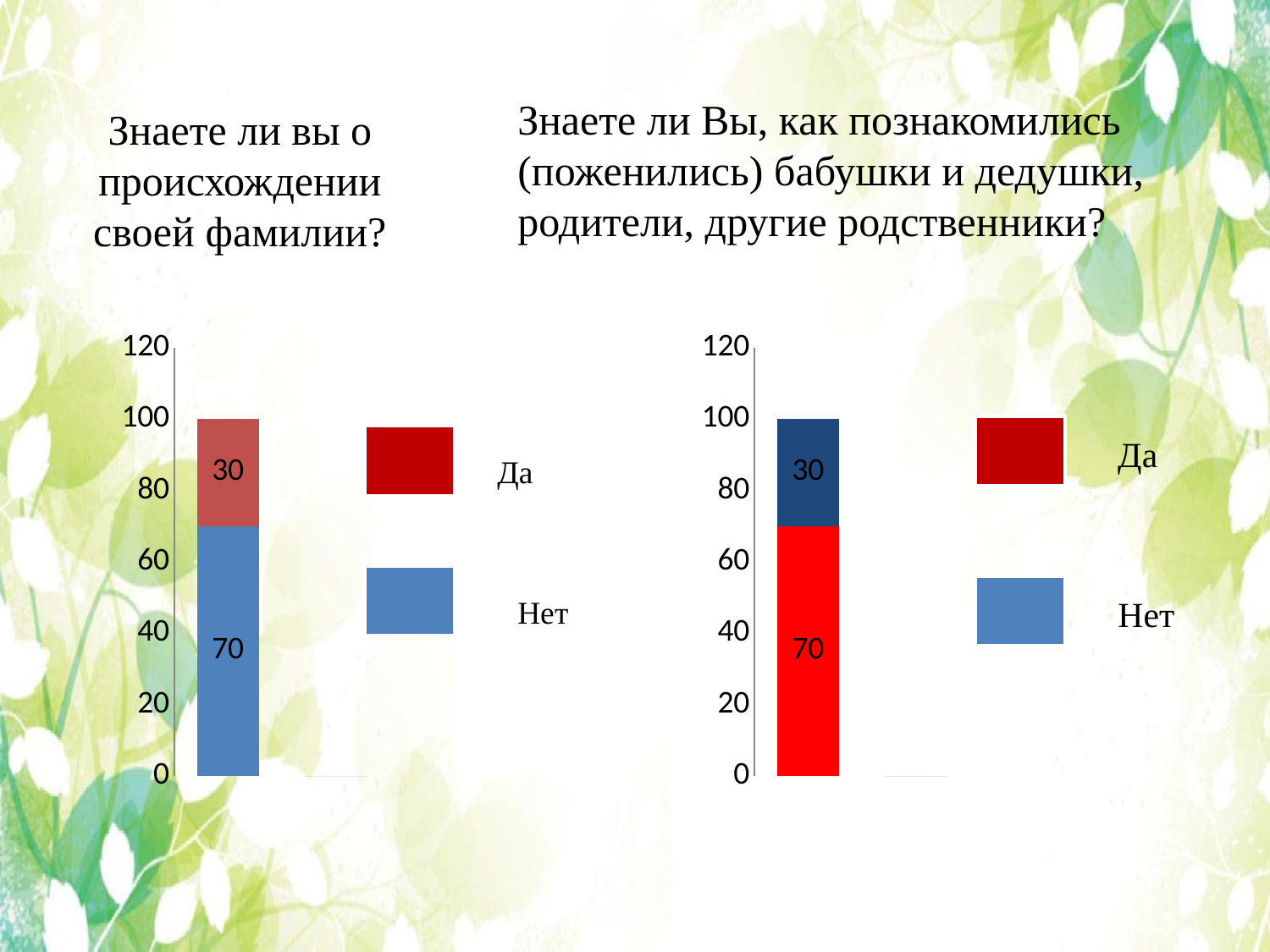
In the left chart (Знаете ли вы о происхождении своей фамилии?), what value is printed on the blue segment of the bar? 70 In the right chart (Знаете ли Вы, как познакомились...), what value is printed on the red segment of the bar? 70 In the right chart, which segment is larger, the red one or the dark blue one? the red one How many entries does the legend of the right chart list? 2 In the right chart (Знаете ли Вы, как познакомились...), what value is printed on the dark blue segment of the bar? 30 In the left chart, is the total height of the stacked bar greater or less than 120? less In the left chart, what is the difference between the blue segment value and the red segment value? 40 In the left chart (Знаете ли вы о происхождении своей фамилии?), what value is printed on the red segment of the bar? 30 What are the two legend entries shown next to the left chart? Да and Нет In the right chart, what is the total of the stacked bar? 100 In the left chart, what is the total of the stacked bar? 100 What type of chart is shown on the left of the slide? bar chart